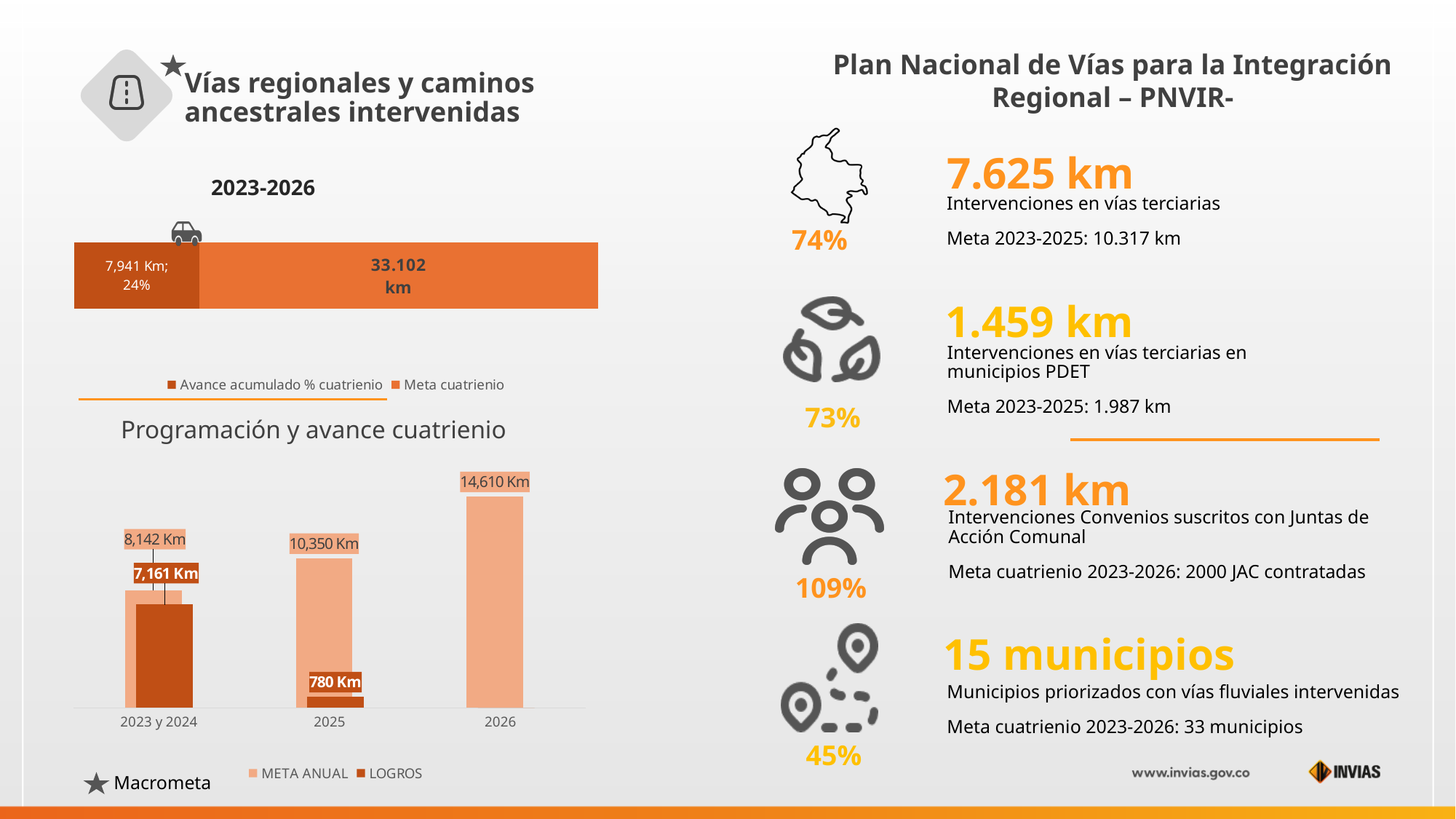
In the 'Programación y avance cuatrienio' chart, what is the difference between the META ANUAL and LOGROS values for 2025? 9,570 Km In the '2023-2026' bar chart at the top left, what percentage is shown for Avance acumulado % cuatrienio? 24% How many series does the legend of the 'Programación y avance cuatrienio' chart list? 2 In the '2023-2026' bar chart at the top left, what is the value shown for Meta cuatrienio? 33.102 km In the 'Programación y avance cuatrienio' chart, which category has the lowest META ANUAL value? 2023 y 2024 In the 'Programación y avance cuatrienio' chart, which category has the highest META ANUAL value? 2026 In the 'Programación y avance cuatrienio' chart, what is the LOGROS value for 2025? 780 Km In the 'Programación y avance cuatrienio' chart, which is larger: the META ANUAL for 2025 or the META ANUAL for 2023 y 2024? META ANUAL for 2025 Do the META ANUAL values in the 'Programación y avance cuatrienio' chart rise or fall from 2023 y 2024 to 2026? rise In the 'Programación y avance cuatrienio' chart, what is the META ANUAL value for 2026? 14,610 Km How many categories are shown on the x axis of the 'Programación y avance cuatrienio' chart? 3 In the 'Programación y avance cuatrienio' chart, what is the LOGROS value for 2023 y 2024? 7,161 Km